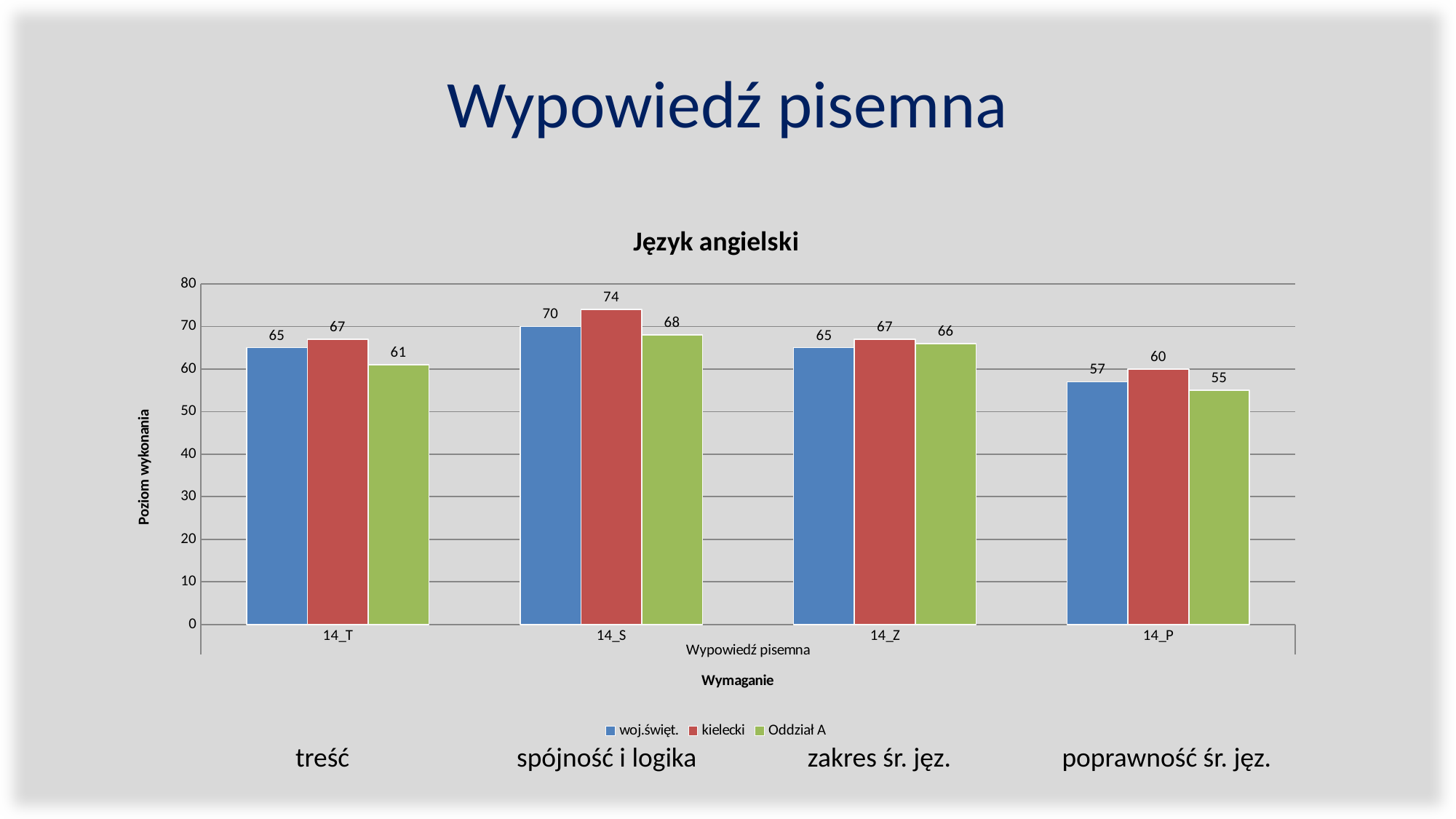
Which is larger in category 14_P: the woj.święt. value or the kielecki value? kielecki What kind of chart is shown on the slide? bar chart What is the title of the chart? Język angielski What is the value for kielecki in category 14_S? 74 Which category has the highest value for the kielecki series? 14_S What is the value for woj.święt. in category 14_Z? 65 What is the difference between the kielecki and Oddział A values in category 14_T? 6 How many series does the legend list? 3 Which category has the lowest value for the Oddział A series? 14_P What is the label of the vertical axis? Poziom wykonania How many categories are shown on the x axis? 4 What is the value for Oddział A in category 14_P? 55